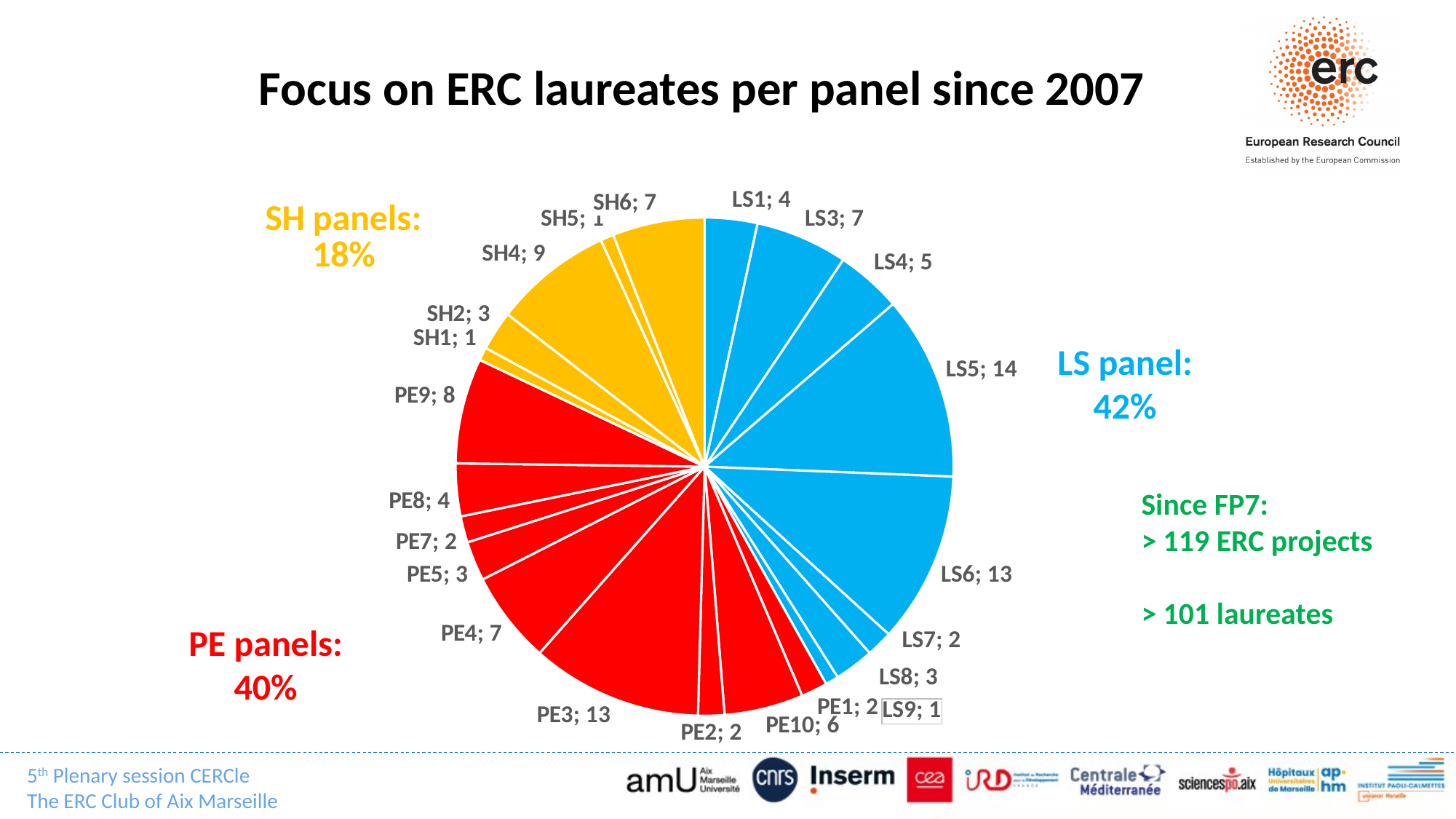
Which panel has the largest slice in the pie chart? LS5 What kind of chart is shown on the slide? pie chart How many panel slices are shown in the pie chart? 22 What is the value shown for panel SH4? 9 How many laureates are shown for panel LS5? 14 What is the value shown for panel PE3? 13 What share of the pie do the LS panels account for, according to the slide? 42% Which PE panel has the highest value? PE3 What is the difference between the values for SH6 and SH2? 4 Which has a larger value, PE9 or PE4? PE9 What is the difference between the values for LS5 and LS6? 1 What is the value shown for panel PE10? 6